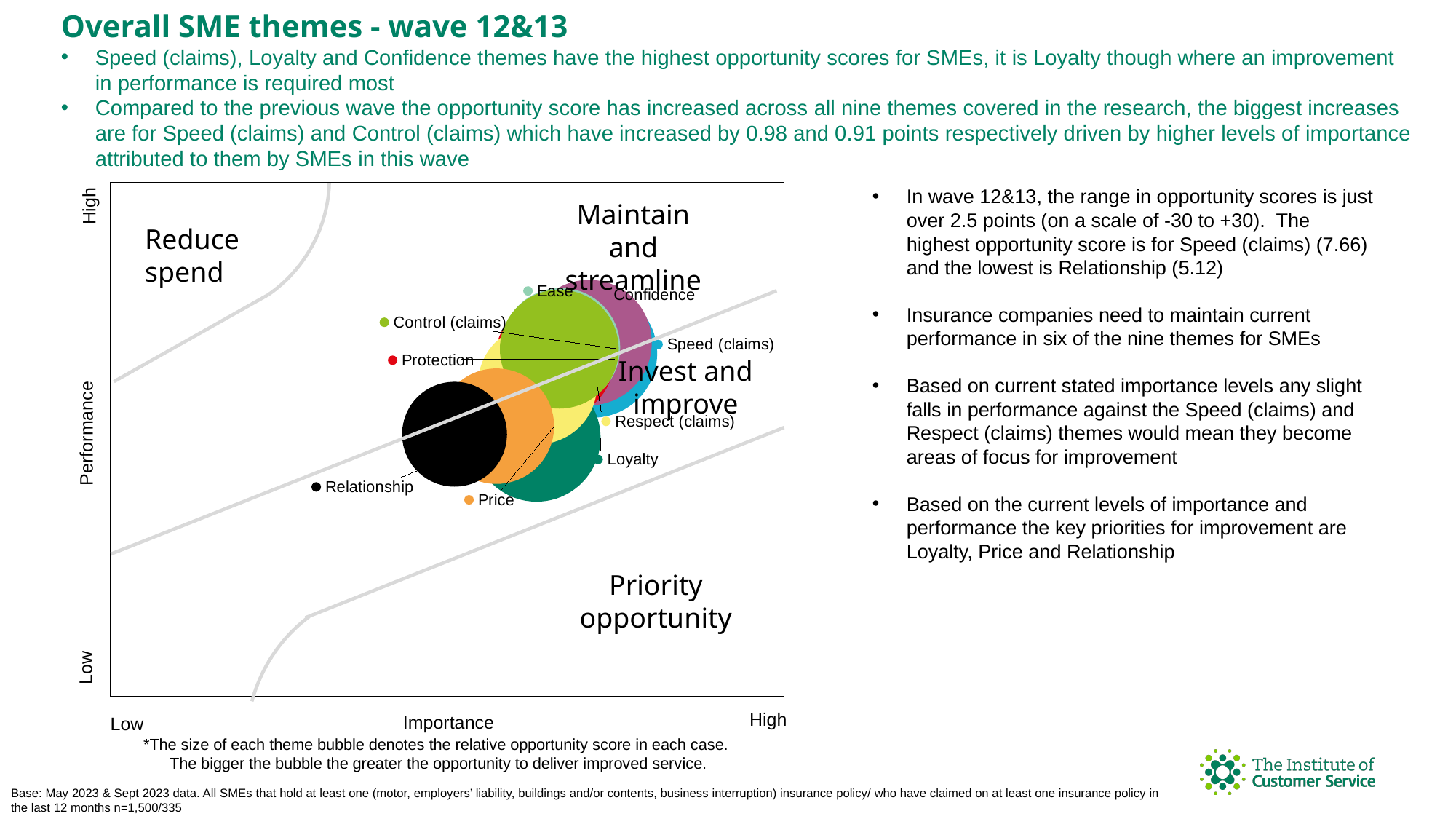
How many theme bubbles are plotted on the chart? 9 Which theme is plotted furthest to the right (highest importance) on the chart? Speed (claims) Which theme is plotted furthest to the left (lowest importance) on the chart? Relationship Which theme is plotted with higher performance, Control (claims) or Loyalty? Control (claims) Which theme is plotted with higher importance, Relationship or Speed (claims)? Speed (claims) What kind of chart is shown on the slide? Bubble chart Which theme is plotted with higher performance, Ease or Price? Ease What is the label of the vertical axis of the chart? Performance What is the label of the horizontal axis of the chart? Importance